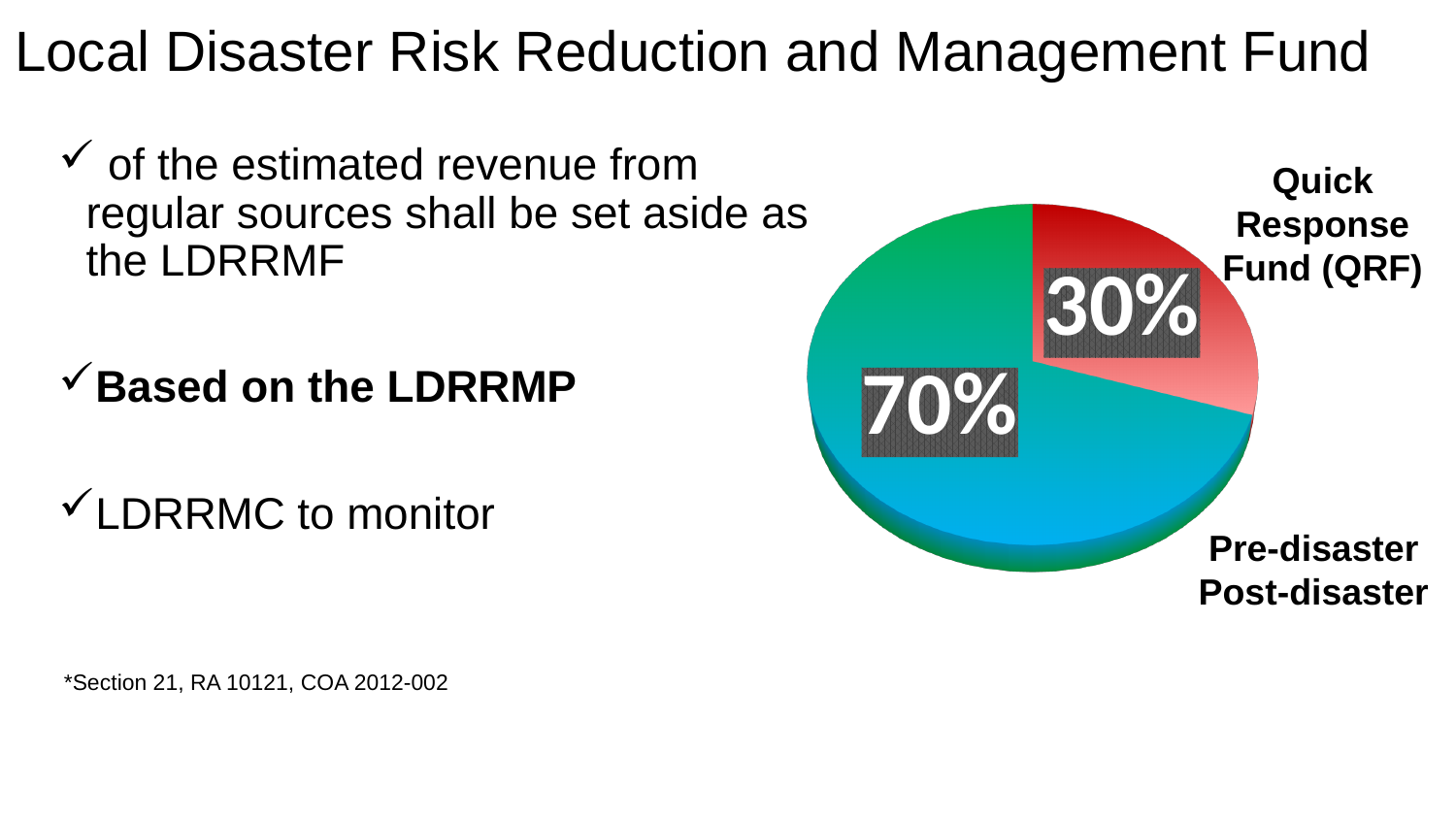
What is the difference in percentage points between the Pre-disaster / Post-disaster slice and the Quick Response Fund (QRF) slice? 40 What kind of chart is shown on the slide? pie chart Which slice of the pie is the smallest? Quick Response Fund (QRF) What is the total of the two slice percentages shown on the pie chart? 100% How many slices does the pie chart have? 2 Is the value for the Quick Response Fund (QRF) slice greater or less than 50%? less What colour is the Quick Response Fund (QRF) slice of the pie? red What share of the pie is labelled for Pre-disaster / Post-disaster? 70% What share of the pie is labelled for the Quick Response Fund (QRF)? 30% Which is larger, the Quick Response Fund (QRF) slice or the Pre-disaster / Post-disaster slice? Pre-disaster / Post-disaster Which slice of the pie is the largest? Pre-disaster / Post-disaster